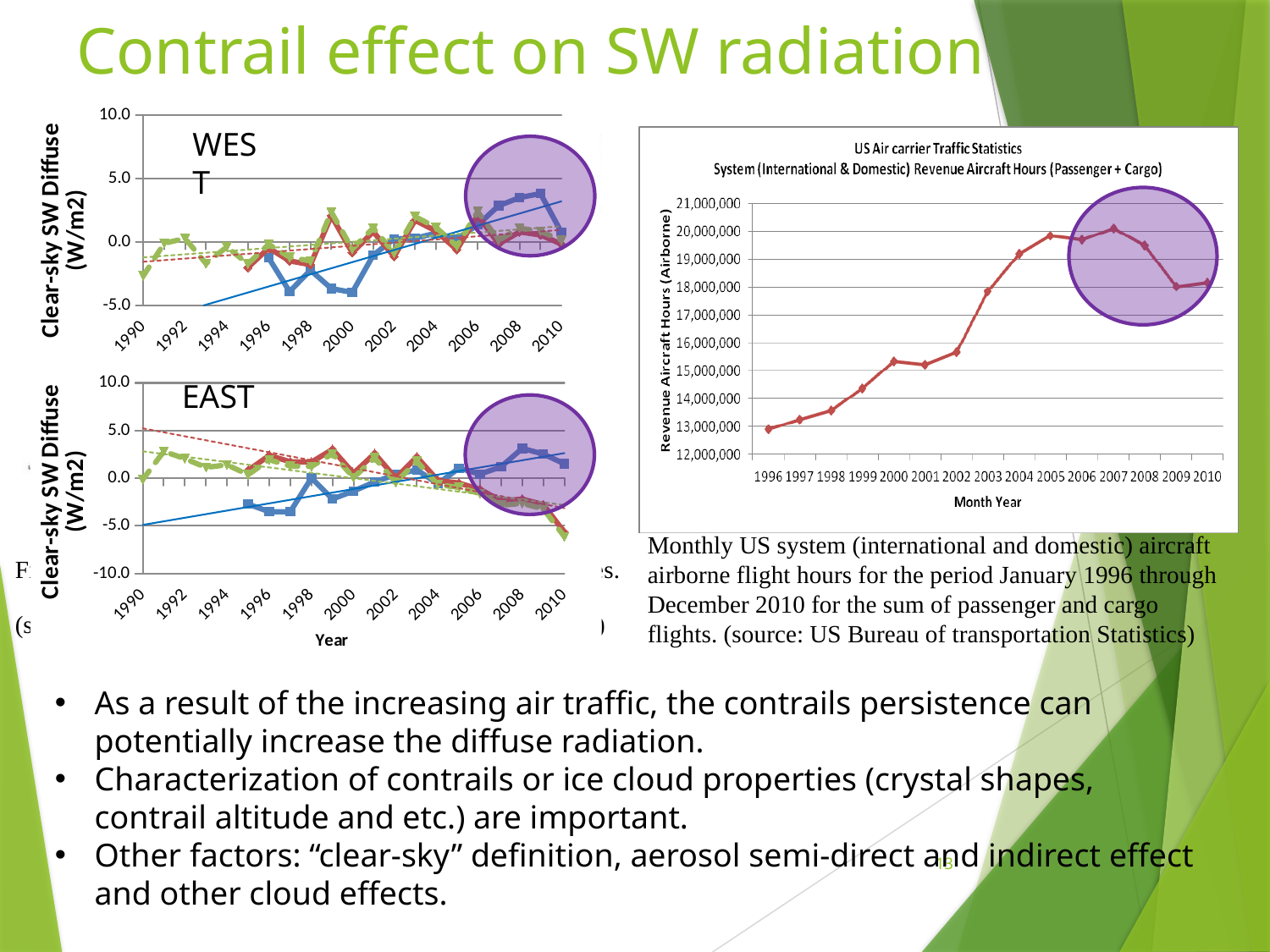
In the US Air carrier Traffic Statistics chart, do the revenue aircraft hours rise or fall from 1996 to 2005? rise What is the x-axis label of the US Air carrier Traffic Statistics chart? Month Year What is the y-axis label of the WEST chart on the left? Clear-sky SW Diffuse (W/m2) In the US Air carrier Traffic Statistics chart, which year has the lowest revenue aircraft hours? 1996 In the EAST chart, is the value of the green line at 2010 greater or less than -5.0? less In the US Air carrier Traffic Statistics chart, which year has the highest revenue aircraft hours? 2007 In the US Air carrier Traffic Statistics chart, is the value for 2009 greater or less than 19,000,000? less In the US Air carrier Traffic Statistics chart, which year has the larger value, 2000 or 2003? 2003 In the US Air carrier Traffic Statistics chart, is the value for 2005 greater or less than 19,000,000? greater What kind of chart is the US Air carrier Traffic Statistics chart on the right? line chart How many year labels are shown on the x axis of the US Air carrier Traffic Statistics chart? 15